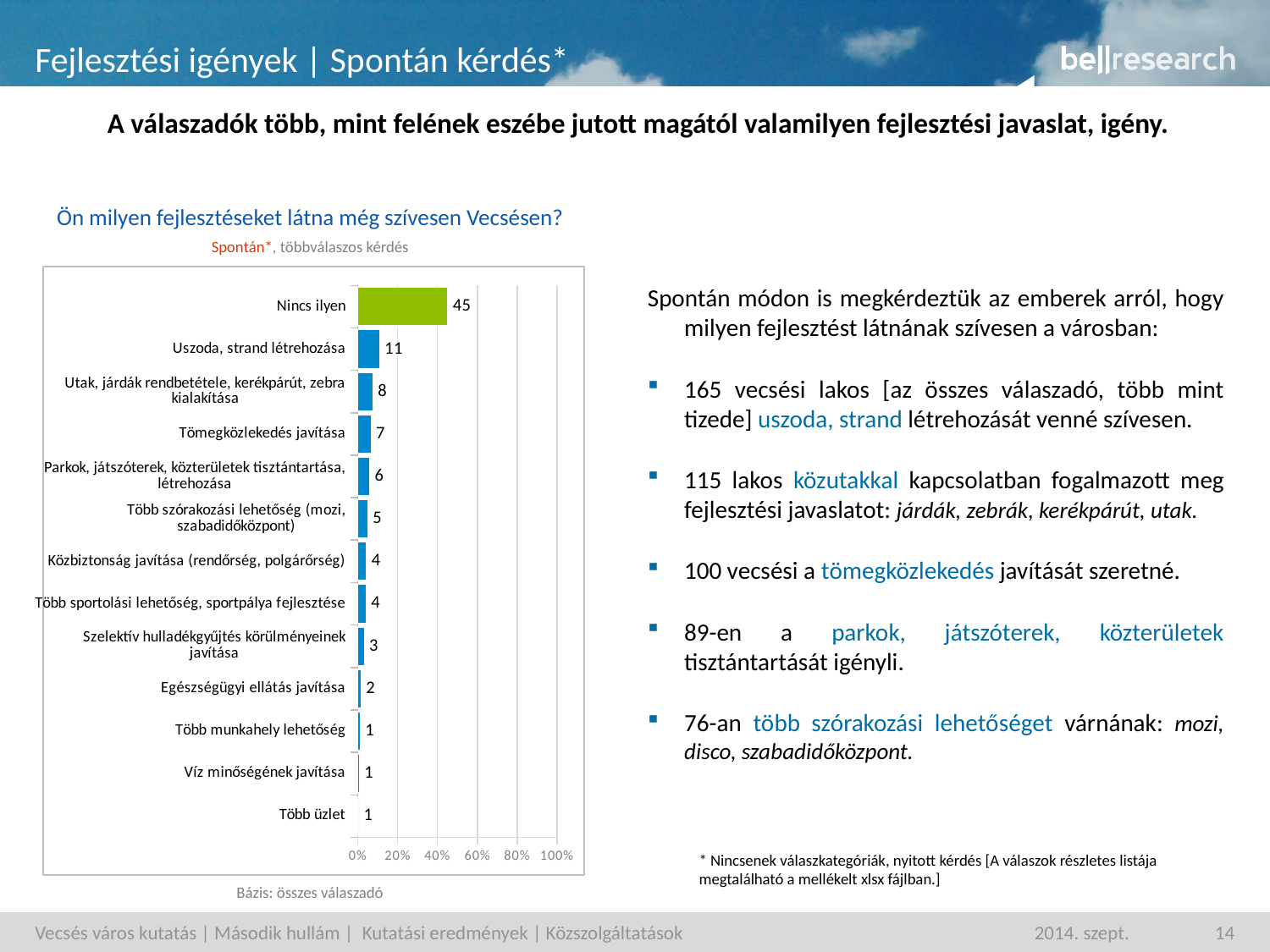
What kind of chart is shown on the slide? Bar chart What is the difference between the values for "Nincs ilyen" and "Uszoda, strand létrehozása"? 34 What is the difference between the values for "Tömegközlekedés javítása" and "Egészségügyi ellátás javítása"? 5 What value is shown for "Uszoda, strand létrehozása"? 11 What value is shown for "Tömegközlekedés javítása"? 7 What is the title of the chart? Ön milyen fejlesztéseket látna még szívesen Vecsésen? What value is shown for "Nincs ilyen"? 45 Is the value for "Nincs ilyen" greater or less than 40%? greater What value is shown for "Szelektív hulladékgyűjtés körülményeinek javítása"? 3 Which category has the highest value? Nincs ilyen Which is larger: the value for "Utak, járdák rendbetétele, kerékpárút, zebra kialakítása" or for "Parkok, játszóterek, közterületek tisztántartása, létrehozása"? Utak, járdák rendbetétele, kerékpárút, zebra kialakítása How many categories are shown in the chart? 13